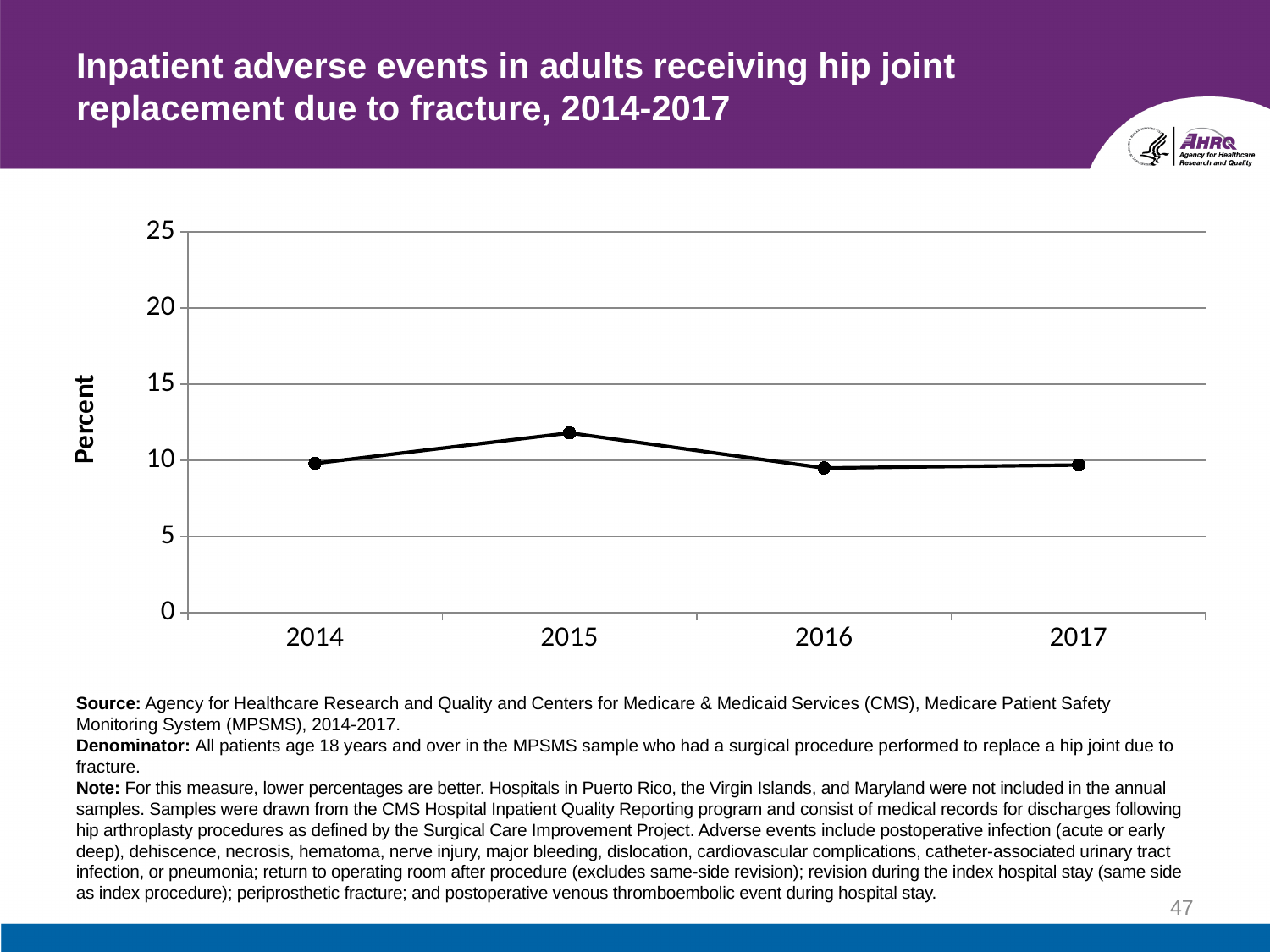
Which year has the highest percentage of inpatient adverse events? 2015 What is the label on the y axis of the chart? Percent Is the value for 2015 greater or less than 15? less Does the value rise or fall from 2015 to 2016? fall Which year has the larger value, 2015 or 2016? 2015 How many years are plotted on the x axis? 4 Which year has the larger value, 2014 or 2015? 2015 Does the value rise or fall from 2014 to 2015? rise Is the value for 2015 greater or less than 10? greater Is the value for 2016 greater or less than 10? less What kind of chart is shown on the slide? line chart